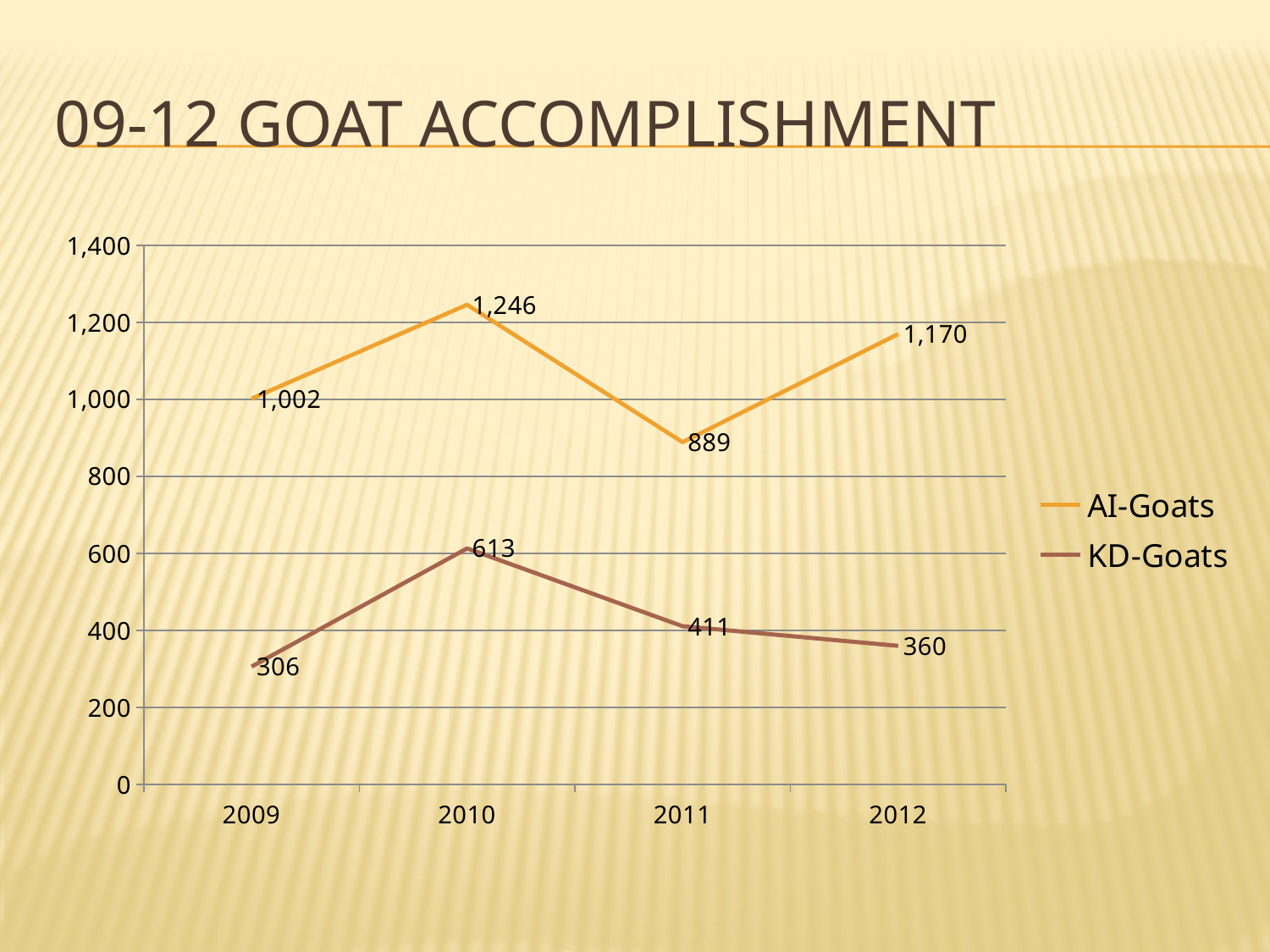
Which is larger, the AI-Goats value for 2009 or the AI-Goats value for 2012? AI-Goats value for 2012 What is the AI-Goats value for 2011? 889 How many series does the legend list? 2 What is the KD-Goats value for 2012? 360 What kind of chart is shown on the slide? Line chart What is the AI-Goats value for 2010? 1,246 What is the KD-Goats value for 2009? 306 How many years are shown on the x axis? 4 What is the difference between the AI-Goats and KD-Goats values in 2012? 810 In which year is the KD-Goats value lowest? 2009 Does the KD-Goats value rise or fall from 2010 to 2012? Fall In which year is the AI-Goats value highest? 2010